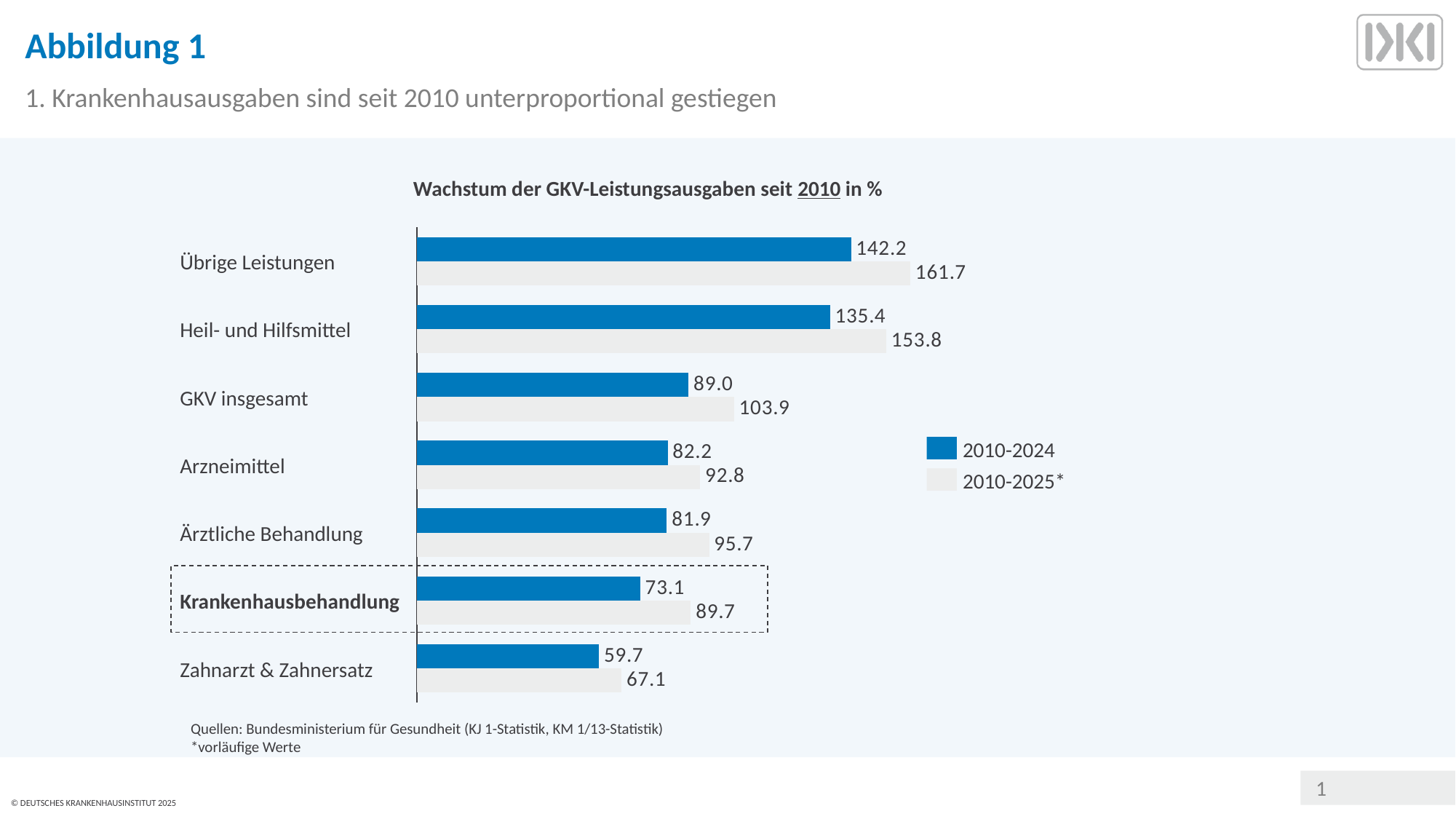
What is the value for GKV insgesamt in the 2010-2025* series? 103.9 What is the title of the chart? Wachstum der GKV-Leistungsausgaben seit 2010 in % Which category has the highest value in the 2010-2025* series? Übrige Leistungen How many series does the legend list? 2 Which is larger in the 2010-2025* series: Arzneimittel or Ärztliche Behandlung? Ärztliche Behandlung What is the value for Krankenhausbehandlung in the 2010-2024 series? 73.1 Which category has the lowest value in the 2010-2024 series? Zahnarzt & Zahnersatz How many categories are shown on the chart? 7 What is the difference between the 2010-2024 values for Übrige Leistungen and Heil- und Hilfsmittel? 6.8 What is the value for Zahnarzt & Zahnersatz in the 2010-2024 series? 59.7 What kind of chart is shown on the slide? Bar chart What is the difference between the 2010-2025* and 2010-2024 values for Krankenhausbehandlung? 16.6